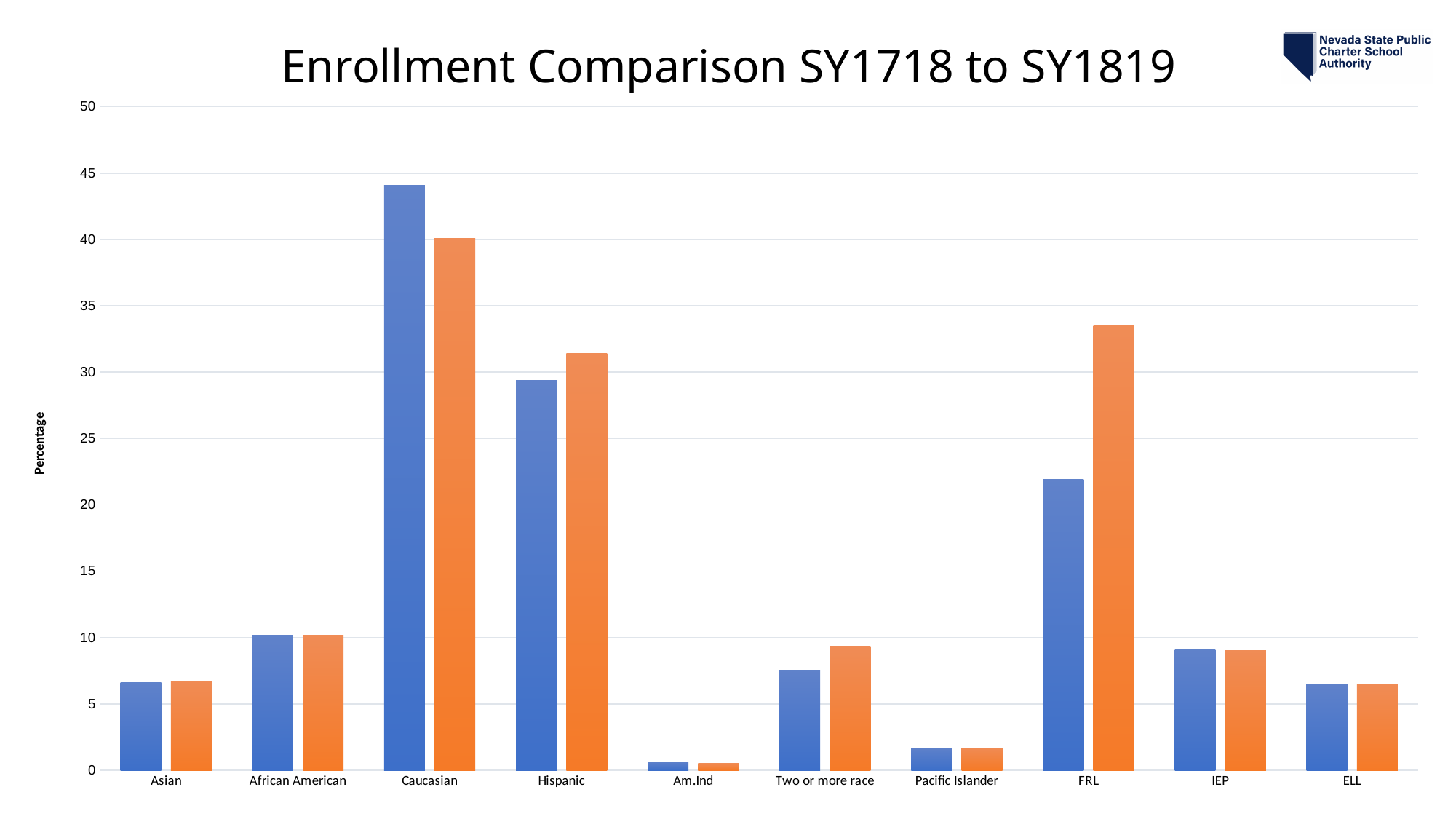
Which category has the shortest bars on the chart? Am.Ind For Caucasian, which bar is taller, the blue bar or the orange bar? blue Is the blue bar for Caucasian greater or less than 40? greater How many categories are shown along the x axis? 10 Is the orange bar for Hispanic greater or less than 30? greater Is the blue bar for FRL greater or less than 25? less What label is shown on the vertical axis? Percentage Which category has the tallest bar on the chart? Caucasian What kind of chart is shown on the slide? bar chart What is the title of the chart? Enrollment Comparison SY1718 to SY1819 For FRL, which bar is taller, the blue bar or the orange bar? orange